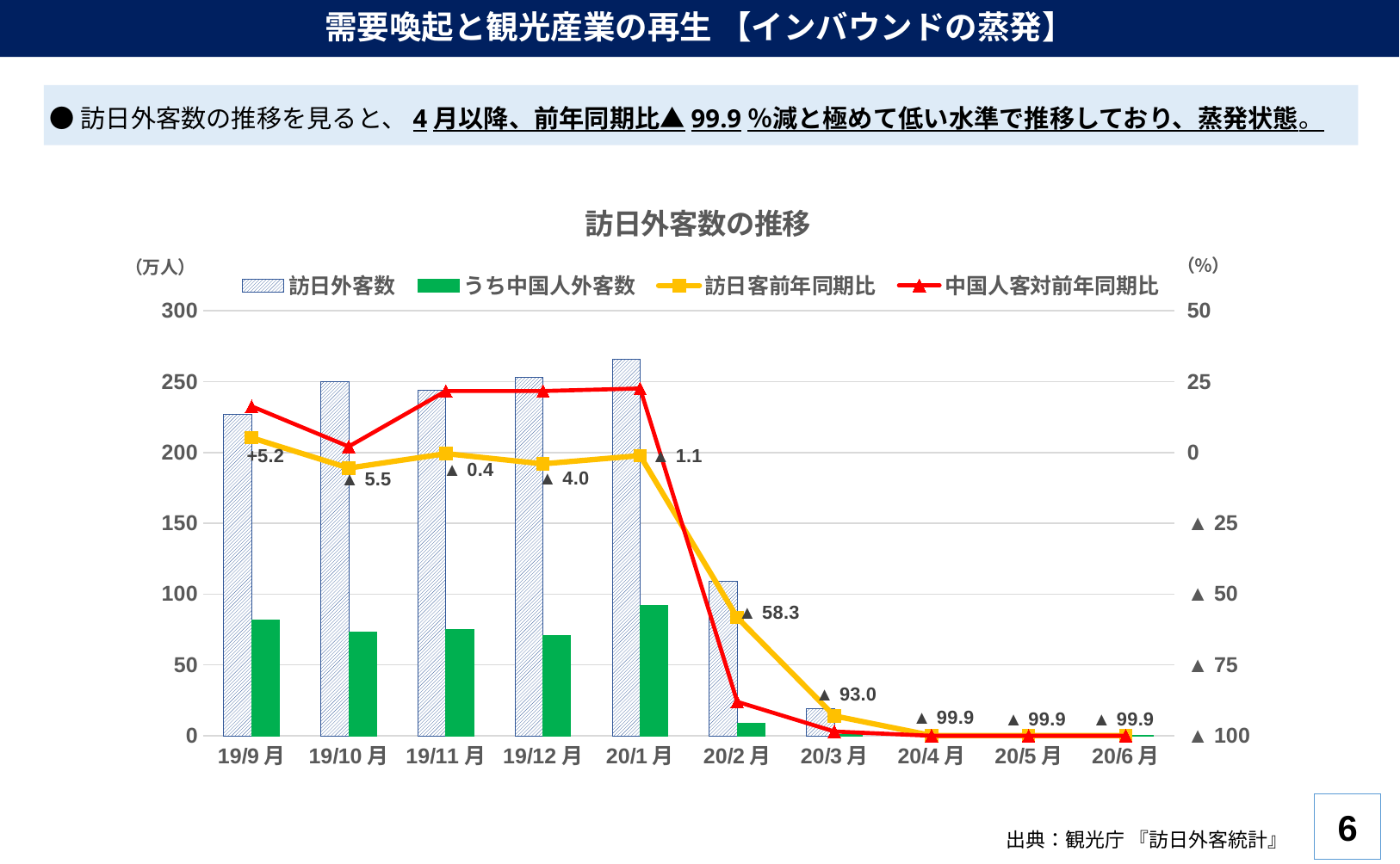
What kind of chart is shown on the slide? Combination bar and line chart Does 訪日外客数 rise or fall from 20/1月 to 20/4月? fall Is the value of うち中国人外客数 for 20/1月 greater or less than 50? greater How many months are shown on the x axis of the chart? 10 What is the value of 訪日客前年同期比 for 19/9月? +5.2 What is the value of 訪日客前年同期比 for 20/2月? ▲ 58.3 What is the value of 訪日客前年同期比 for 20/3月? ▲ 93.0 What is the value of 訪日客前年同期比 for 20/5月? ▲ 99.9 How many series does the legend list? 4 Is the value of 訪日外客数 for 20/1月 greater or less than 250? greater What is the title of the chart? 訪日外客数の推移 Which month has the highest 訪日外客数 bar? 20/1月